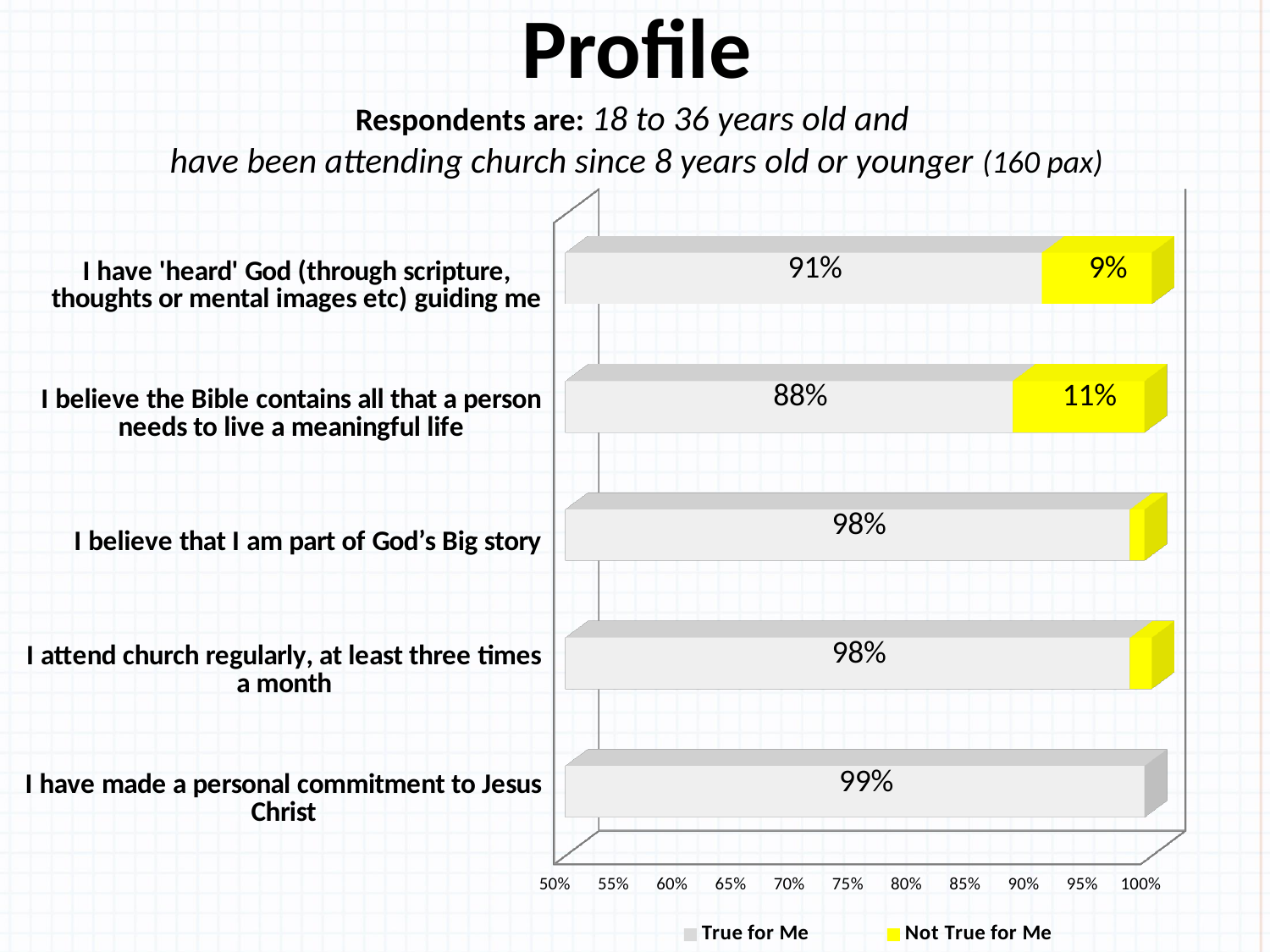
Which statement has the lowest 'True for Me' value? I believe the Bible contains all that a person needs to live a meaningful life What is the 'True for Me' value for 'I believe the Bible contains all that a person needs to live a meaningful life'? 88% Which is larger: the 'Not True for Me' value for 'I have 'heard' God guiding me' or for 'I believe the Bible contains all that a person needs to live a meaningful life'? I believe the Bible contains all that a person needs to live a meaningful life What is the 'Not True for Me' value for 'I have 'heard' God (through scripture, thoughts or mental images etc) guiding me'? 9% What kind of chart is shown on the slide? bar chart What is the difference between the 'True for Me' values for 'I have 'heard' God guiding me' and 'I believe the Bible contains all that a person needs to live a meaningful life'? 3% Which series is shown in yellow in the chart? Not True for Me Which statement has the highest 'True for Me' value? I have made a personal commitment to Jesus Christ How many series does the legend list? 2 How many statements (categories) are plotted in the chart? 5 What is the 'True for Me' value for 'I have made a personal commitment to Jesus Christ'? 99% What is the 'Not True for Me' value for 'I believe the Bible contains all that a person needs to live a meaningful life'? 11%